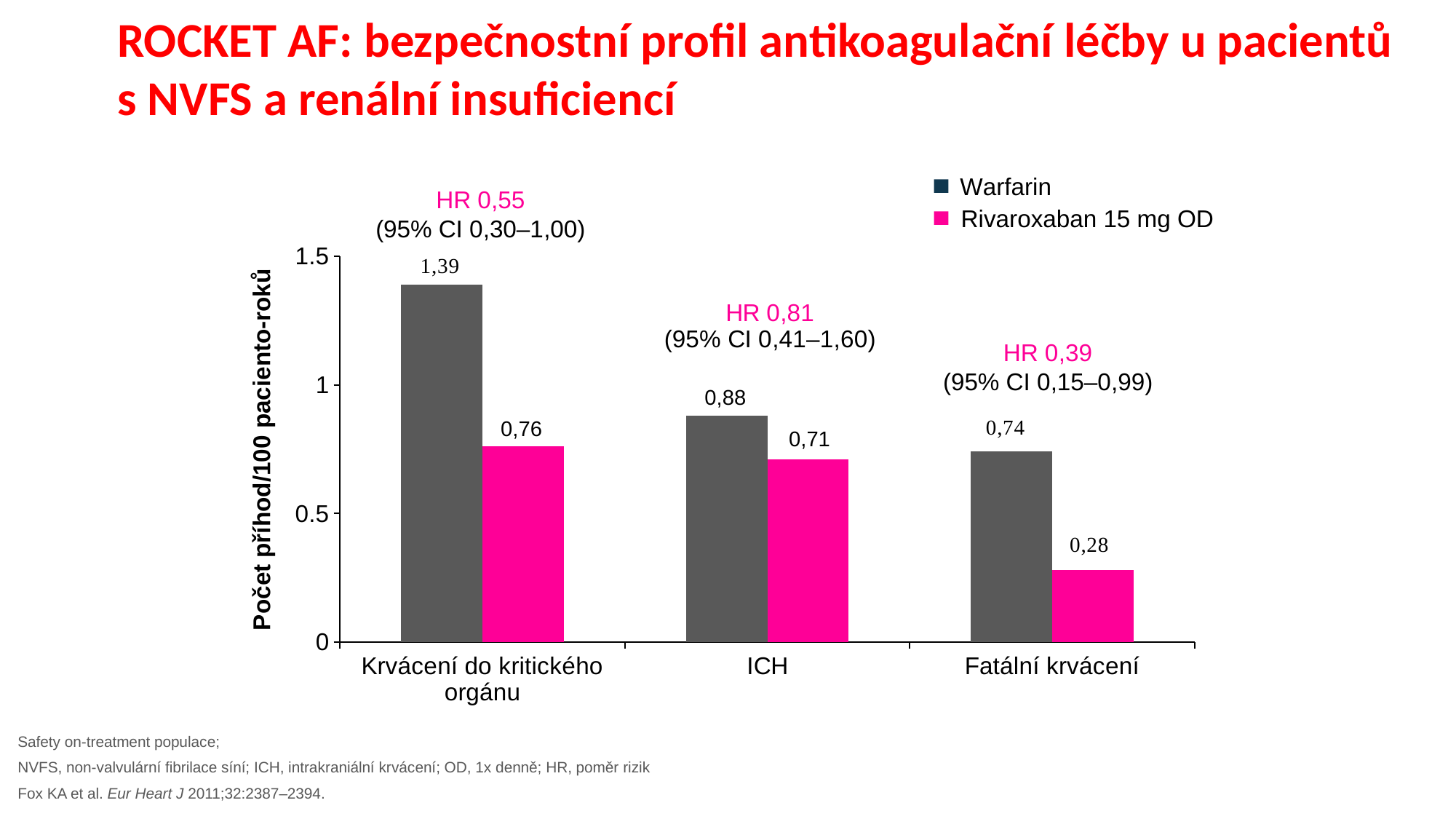
Which category has the lowest Rivaroxaban 15 mg OD value? Fatální krvácení What is the value for Rivaroxaban 15 mg OD in the ICH category? 0,71 What kind of chart is shown on the slide? Bar chart What hazard ratio (HR) is shown above the 'Fatální krvácení' category? HR 0,39 What is the value for Warfarin in the 'Krvácení do kritického orgánu' category? 1,39 What is the difference between the Warfarin and Rivaroxaban 15 mg OD values in the 'Krvácení do kritického orgánu' category? 0,63 Which is larger in the ICH category: the Warfarin value or the Rivaroxaban 15 mg OD value? Warfarin How many series does the legend list? 2 What is the value for Rivaroxaban 15 mg OD in the 'Fatální krvácení' category? 0,28 Is the Warfarin value for 'Fatální krvácení' greater or less than 0.5? greater How many categories are shown on the x axis? 3 Which category has the highest Warfarin value? Krvácení do kritického orgánu